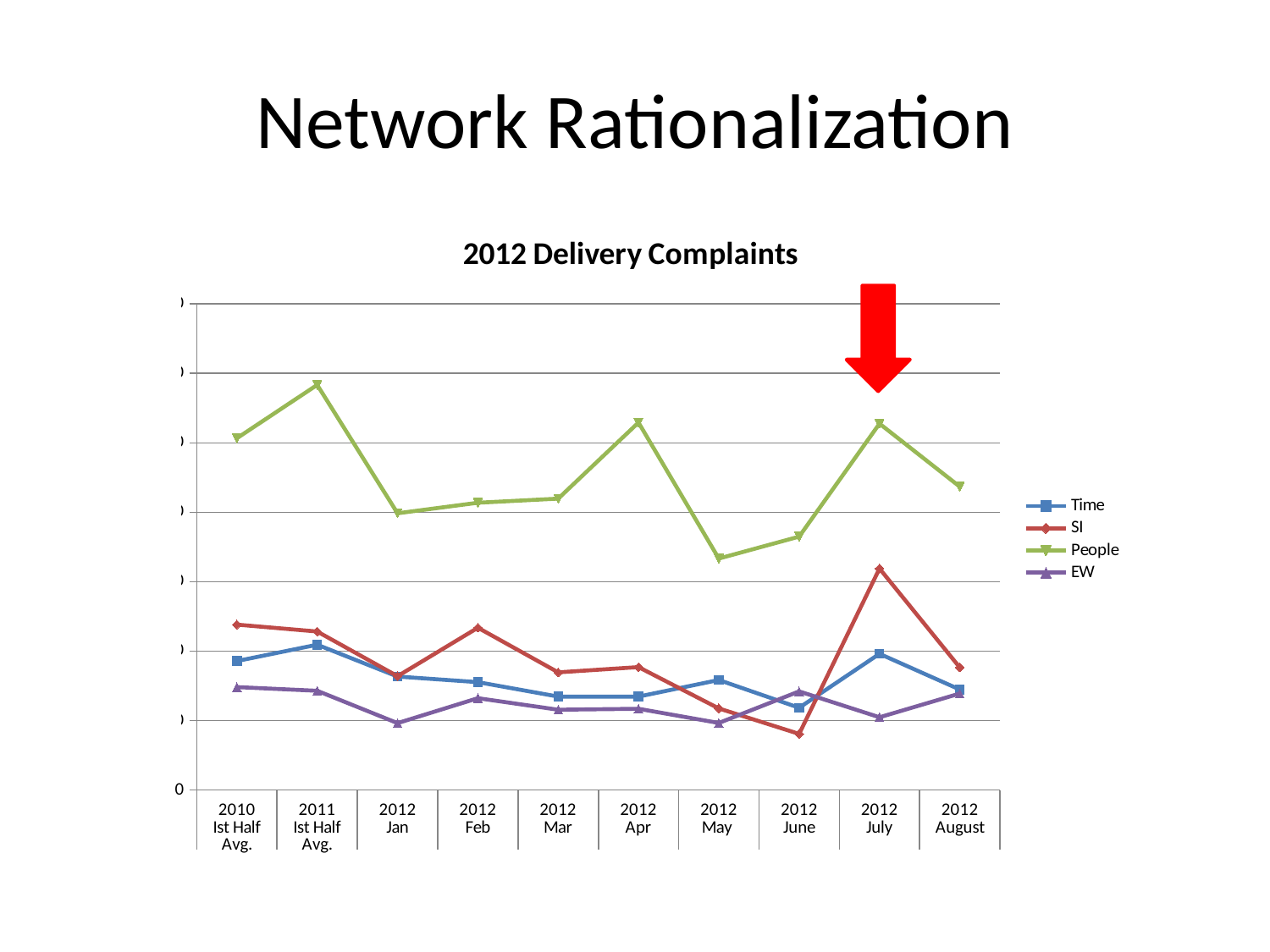
In 2012 July, which is higher, SI or Time? SI Does the SI series rise or fall from 2012 June to 2012 July? rise Which series has the lowest value in 2012 June? SI Which series has the highest value in 2012 July? People What is the title of the chart? 2012 Delivery Complaints What are the series names listed in the chart legend? Time, SI, People, EW Does the People series rise or fall from 2012 Apr to 2012 May? fall In which category does the People series reach its highest value? 2011 Ist Half Avg. What kind of chart is shown on the slide? line chart How many categories are shown along the x axis of the chart? 10 In which category does the SI series reach its lowest value? 2012 June How many series does the legend of the chart list? 4